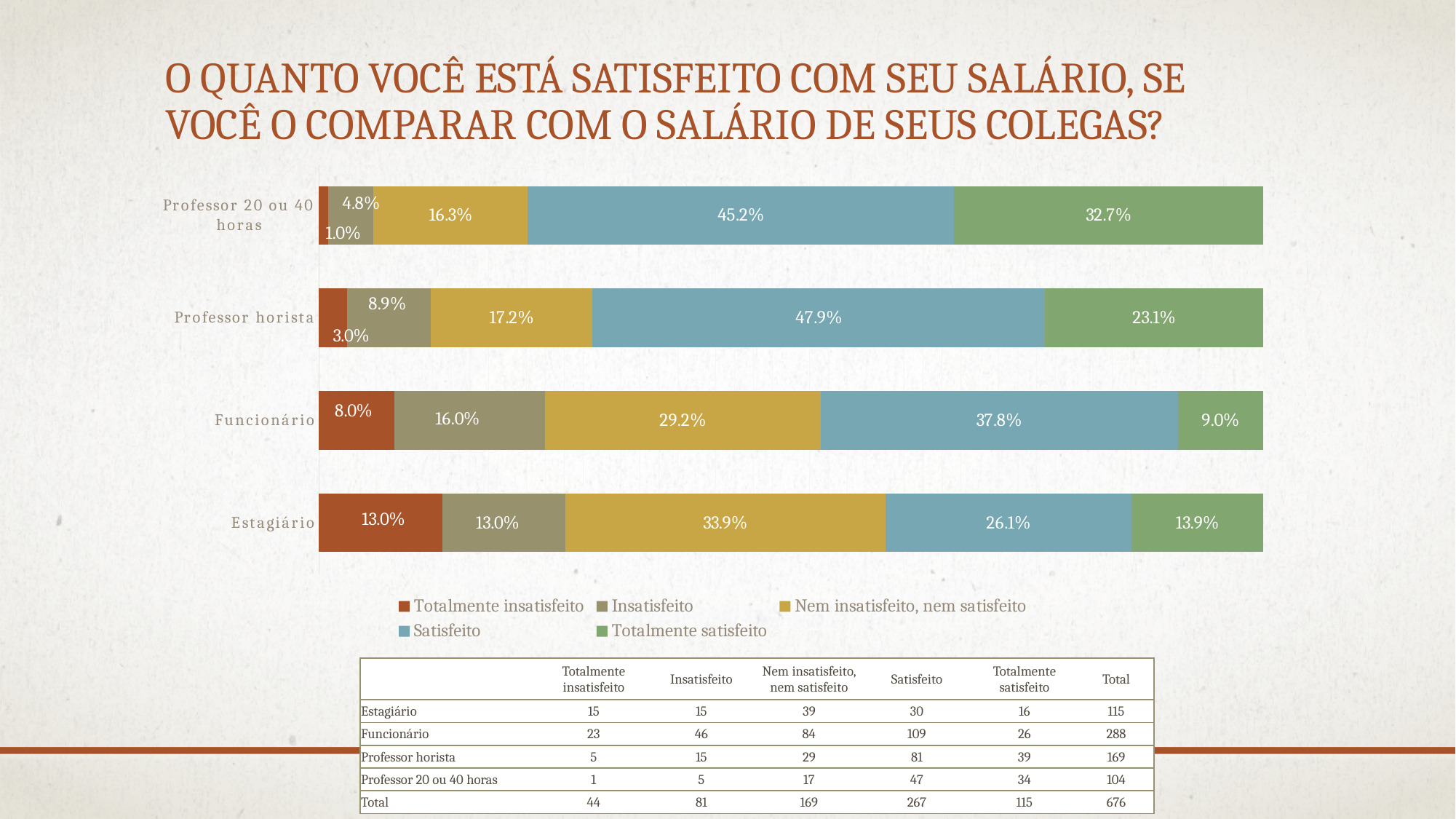
What is the 'Nem insatisfeito, nem satisfeito' value for Estagiário? 33.9% What is the difference between the 'Satisfeito' values for Professor horista and Estagiário? 21.8% What is the 'Satisfeito' value for Professor horista? 47.9% Which legend entry is shown in the dark red colour? Totalmente insatisfeito How many categories (groups) are plotted in the chart? 4 What kind of chart is shown on the slide? Stacked bar chart Which category has the lowest 'Totalmente satisfeito' share? Funcionário Which category has the highest 'Totalmente insatisfeito' share? Estagiário Which is larger: the 'Insatisfeito' value for Funcionário or for Professor horista? Funcionário What is the 'Totalmente satisfeito' value for Professor 20 ou 40 horas? 32.7% What is the 'Totalmente insatisfeito' value for Funcionário? 8.0% How many series does the chart legend list? 5